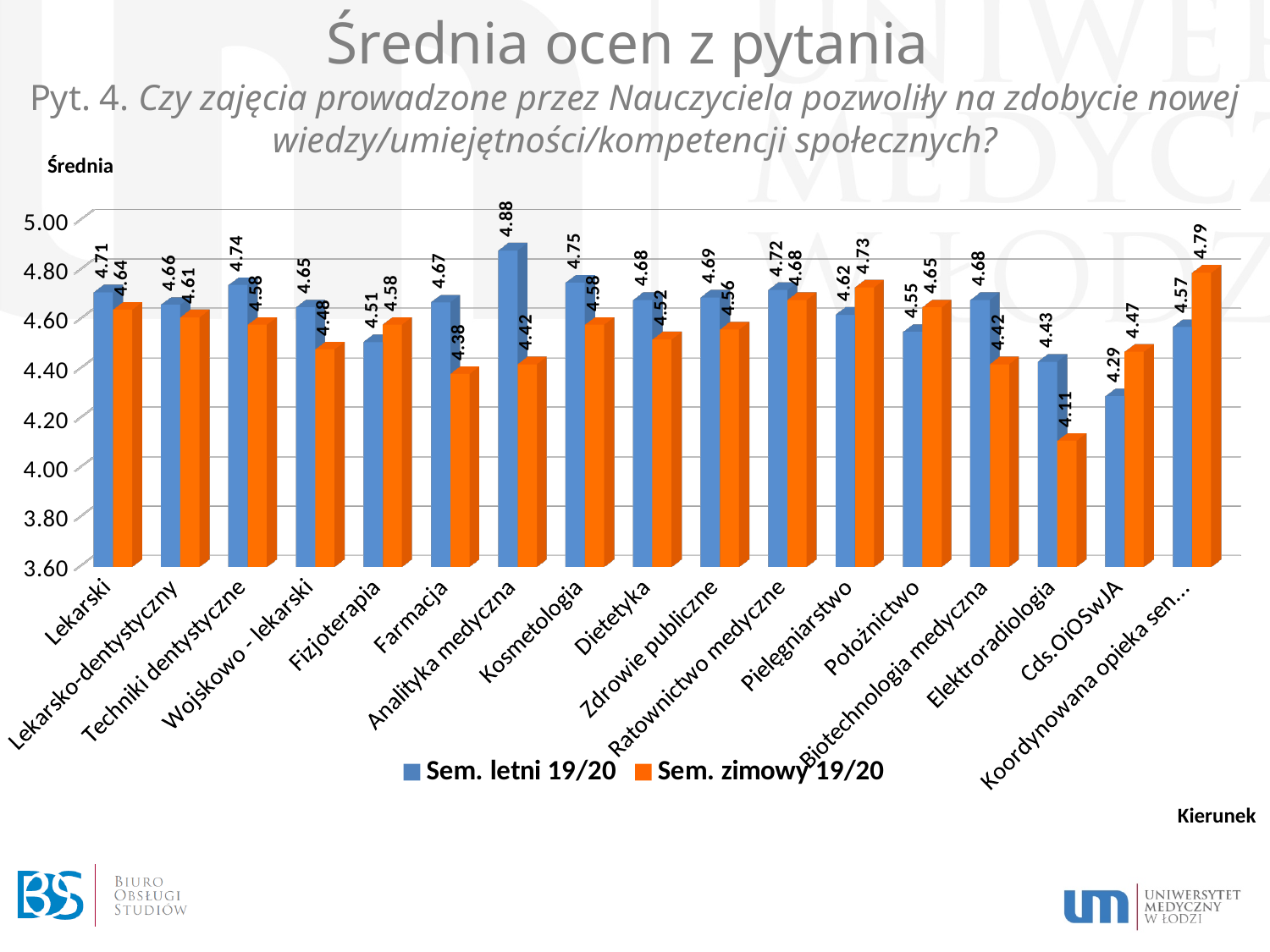
Which is larger for Farmacja: the Sem. letni 19/20 value or the Sem. zimowy 19/20 value? Sem. letni 19/20 Which category has the lowest value in Sem. zimowy 19/20? Elektroradiologia Which category has the highest value in Sem. letni 19/20? Analityka medyczna What is the value for Elektroradiologia in Sem. zimowy 19/20? 4.11 What is the value for Pielęgniarstwo in Sem. zimowy 19/20? 4.73 Which category has the lowest value in Sem. letni 19/20? Cds.OiOSwJA What kind of chart is shown on the slide? bar chart How many categories (kierunki) are shown on the x axis? 17 What is the value for Lekarski in Sem. letni 19/20? 4.71 How many series does the legend list? 2 What is the difference between the Sem. letni 19/20 and Sem. zimowy 19/20 values for Analityka medyczna? 0.46 Is the Sem. zimowy 19/20 value for Elektroradiologia greater or less than 4.20? less